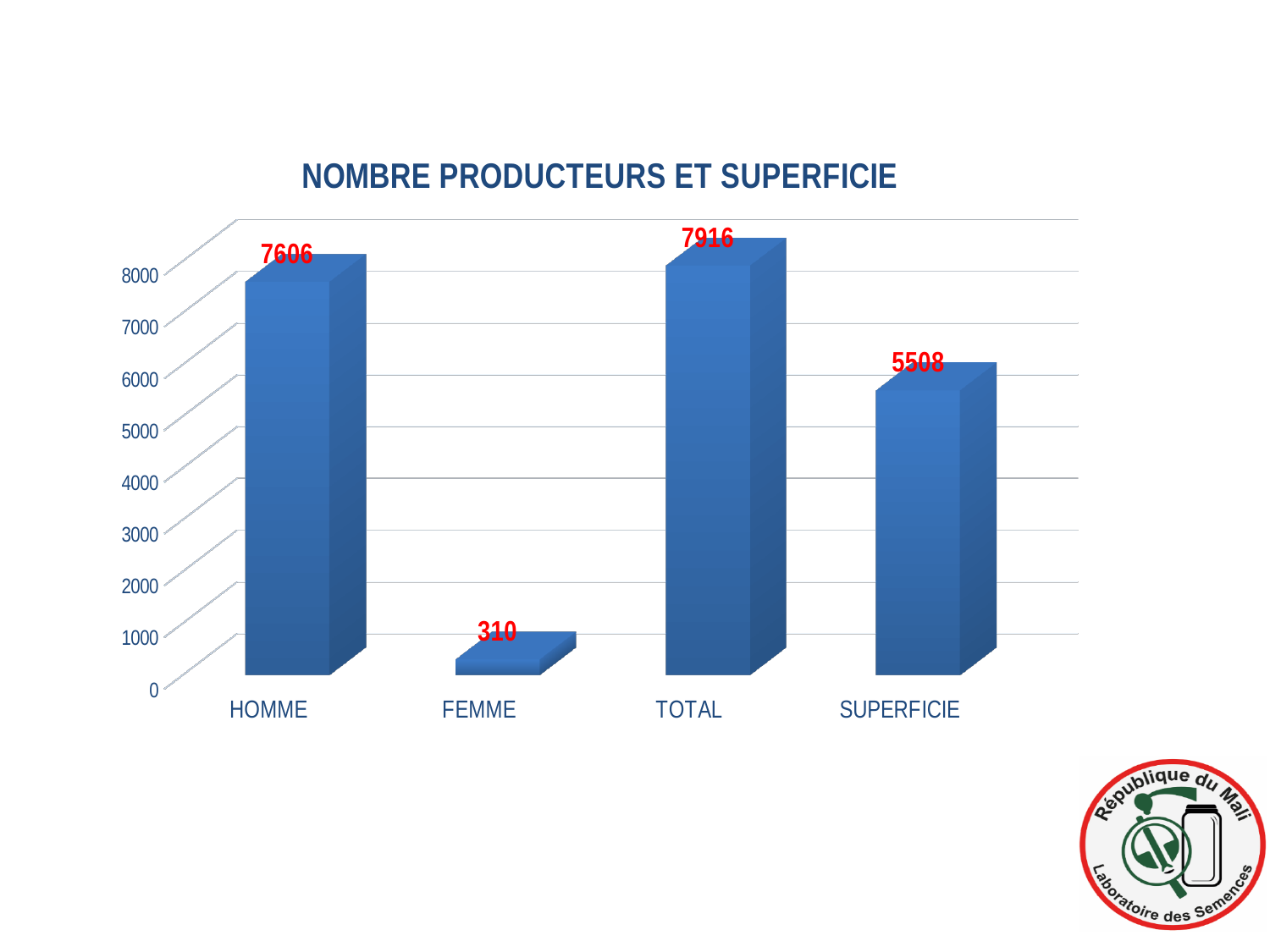
What is the difference between the values for TOTAL and SUPERFICIE? 2408 How many categories are shown on the x axis? 4 Is the value for SUPERFICIE greater or less than 5000? greater Which category has the lowest value? FEMME What is the value for TOTAL? 7916 Which category has the highest value? TOTAL What is the difference between the values for HOMME and FEMME? 7296 What kind of chart is shown on the slide? bar chart Which is larger, the value for HOMME or the value for SUPERFICIE? HOMME What is the value for SUPERFICIE? 5508 What is the value for FEMME? 310 What is the value for HOMME? 7606